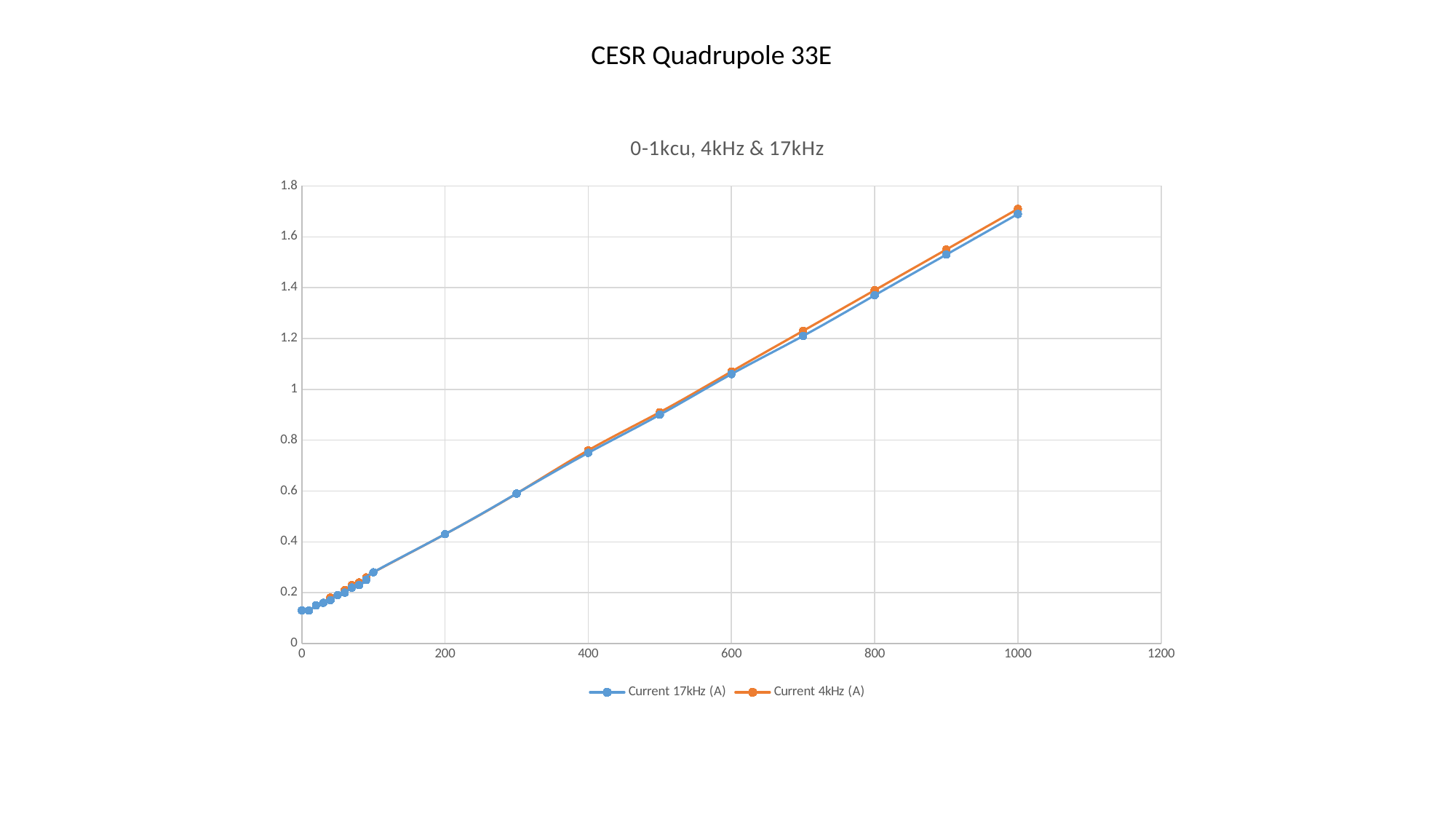
Is the value for Current 17kHz (A) at x = 1000 greater or less than 1.6? greater Is the value for Current 4kHz (A) at x = 800 greater or less than 1.2? greater What is the title of the chart? 0-1kcu, 4kHz & 17kHz Which series is drawn in orange? Current 4kHz (A) Is the value for Current 4kHz (A) at x = 500 greater or less than 0.8? greater What kind of chart is shown on the slide? line chart Do the values of Current 17kHz (A) rise or fall as the x axis increases? rise At x = 1000, which series has the larger value, Current 4kHz (A) or Current 17kHz (A)? Current 4kHz (A) How many series does the legend list? 2